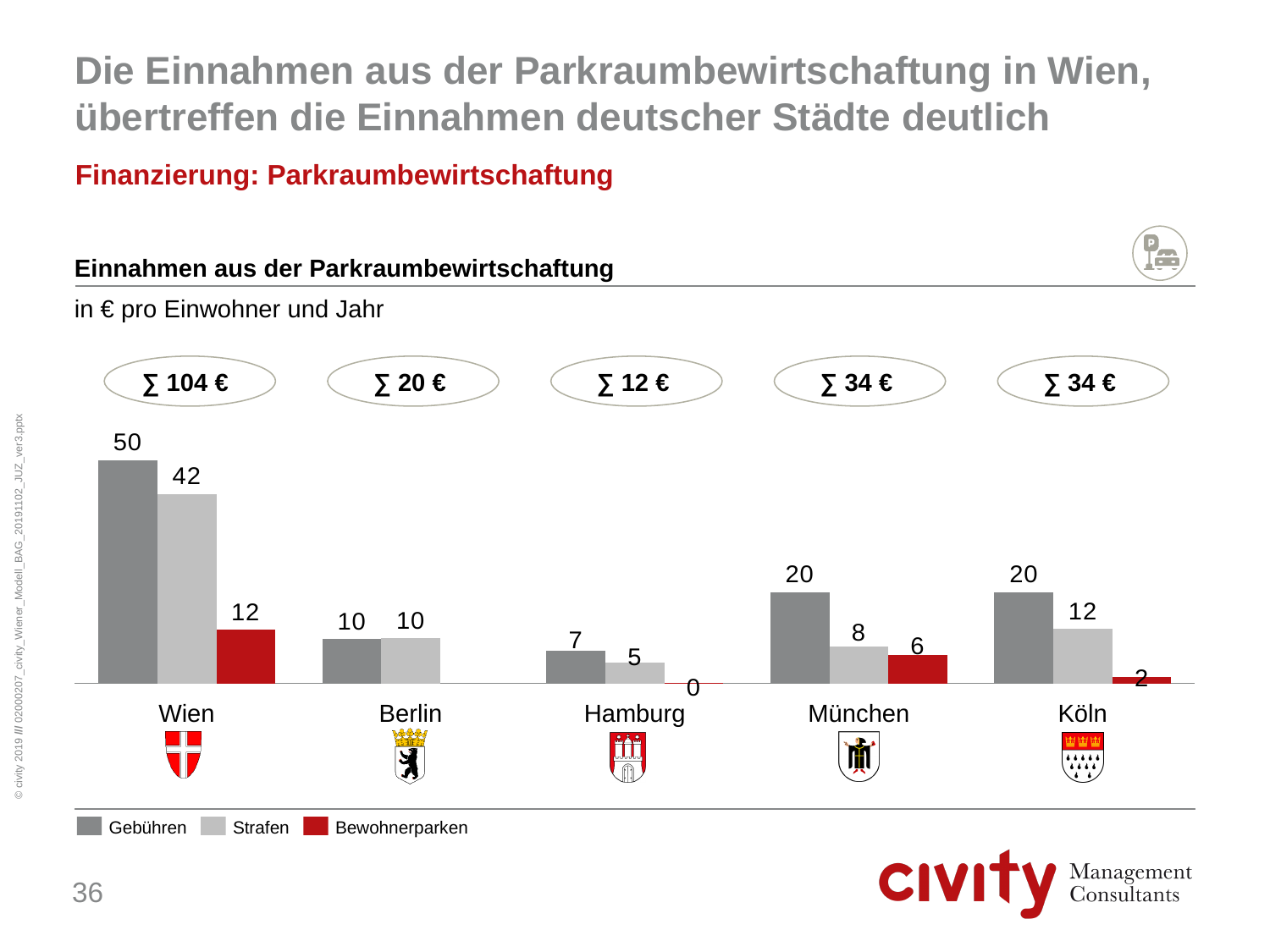
What kind of chart is shown? Bar chart Which city has the highest Gebühren value? Wien Which is larger, the Bewohnerparken value for Wien or for Köln? Wien What is the Bewohnerparken value for Hamburg? 0 How many cities are shown on the x axis? 5 What is the Strafen value for Köln? 12 What is the Gebühren value for Wien? 50 Which city has the lowest Strafen value? Hamburg What is the total (∑) shown for Hamburg? 12 € What is the difference between the Gebühren and Strafen values for Wien? 8 How many series does the legend list? 3 What is the Bewohnerparken value for München? 6